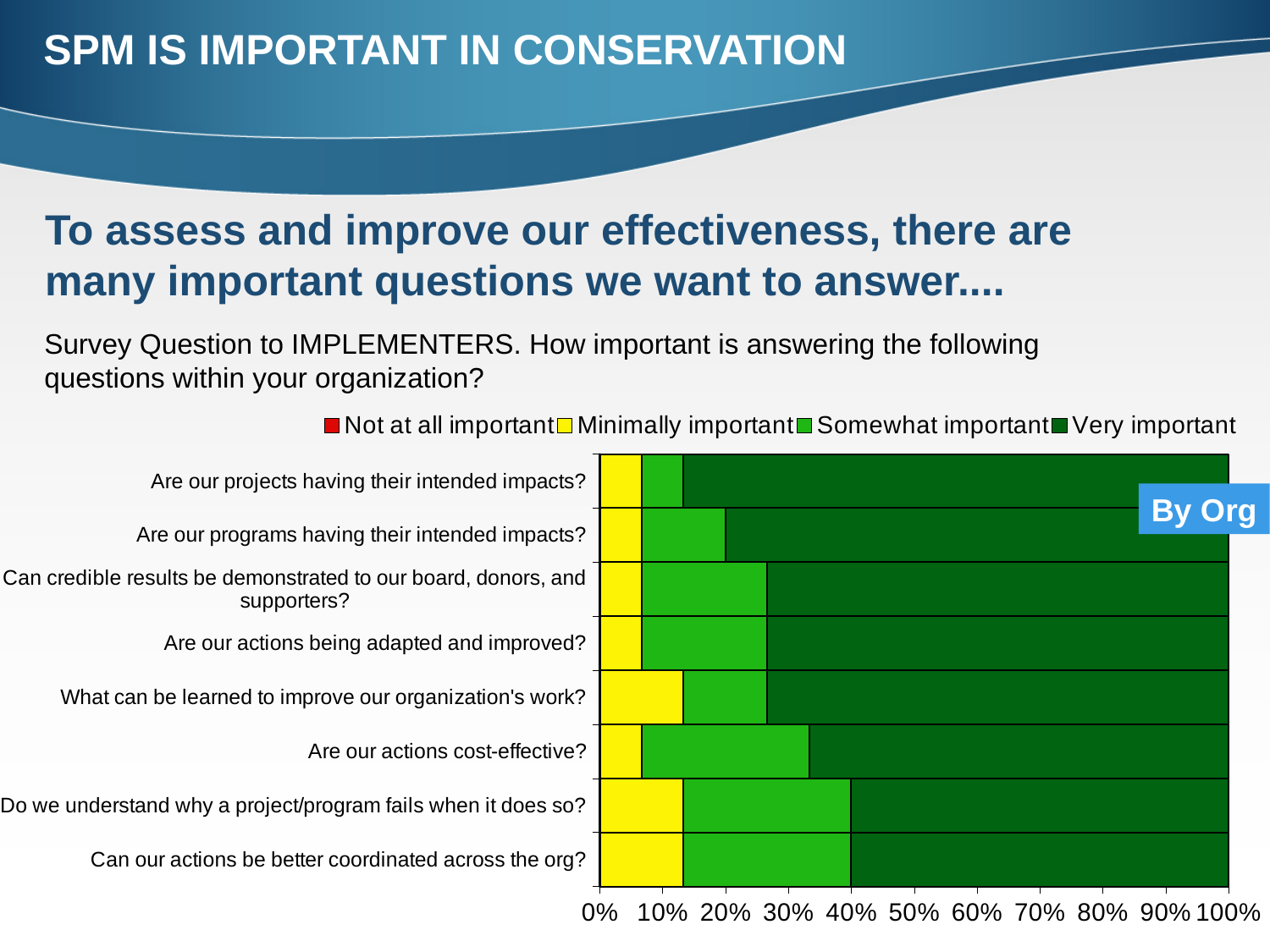
Which category has the largest 'Very important' share? Are our projects having their intended impacts? Which has the larger 'Very important' share: 'Are our projects having their intended impacts?' or 'Can our actions be better coordinated across the org?' Are our projects having their intended impacts? Is the 'Minimally important' share for 'Are our projects having their intended impacts?' greater or less than 10%? less What kind of chart is shown on the slide? Stacked bar chart Is the 'Very important' share for 'Are our projects having their intended impacts?' greater or less than 80%? greater Is the 'Somewhat important' share for 'Are our actions cost-effective?' greater or less than 20%? greater Which series is shown in dark green in the legend? Very important How many survey questions (categories) are plotted on the chart? 8 How many series does the chart legend list? 4 What is the total of each stacked bar on the chart? 100% What is the label on the blue box at the right of the chart? By Org